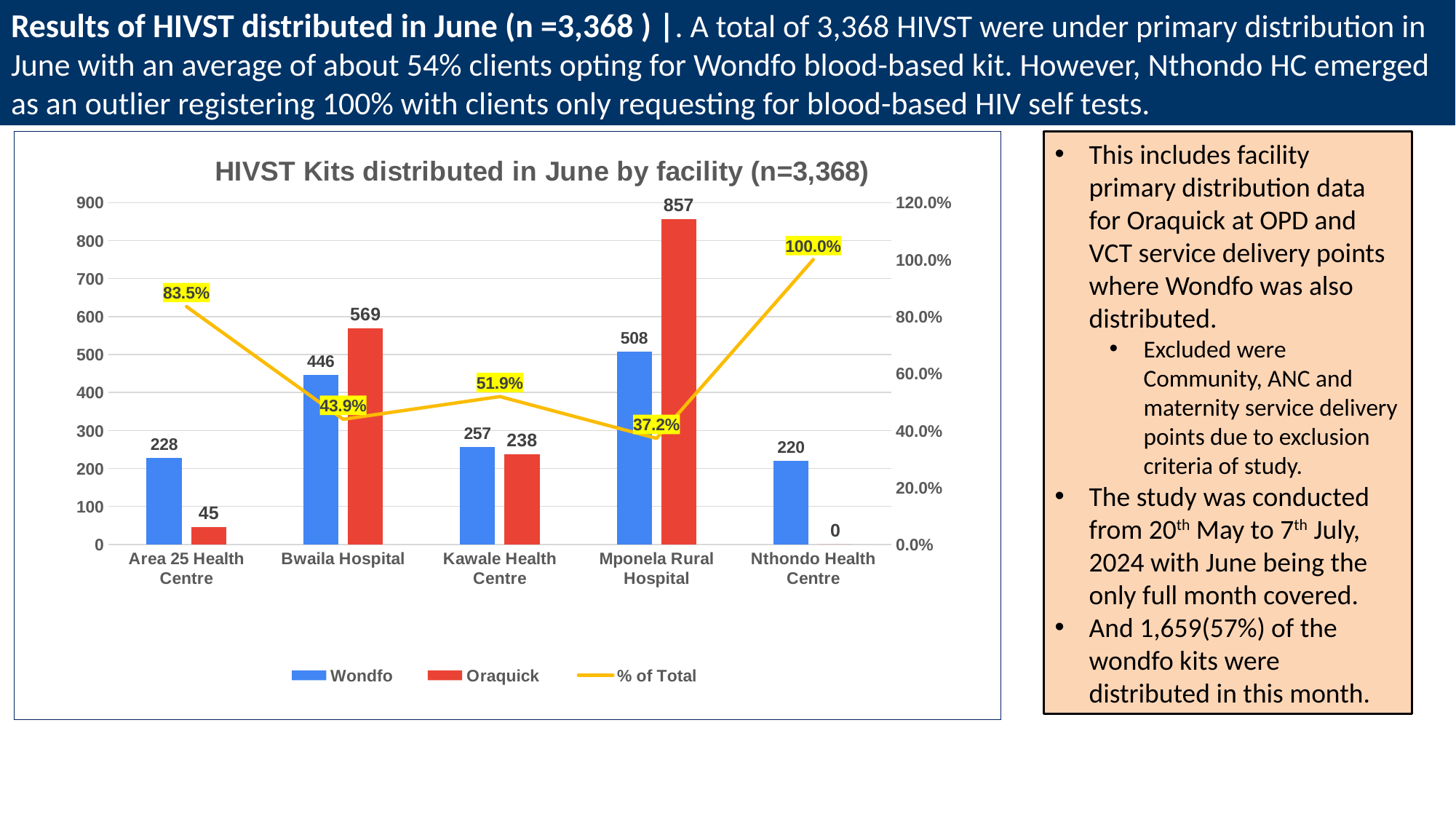
What is the Oraquick value for Area 25 Health Centre? 45 What kind of chart is used to show the Wondfo and Oraquick values? Bar chart What is the difference between the Oraquick and Wondfo values for Bwaila Hospital? 123 What is the title of the chart? HIVST Kits distributed in June by facility (n=3,368) Which facility has the highest Wondfo value? Mponela Rural Hospital How many facilities are shown on the x axis? 5 What is the Wondfo value for Bwaila Hospital? 446 What is the Oraquick value for Mponela Rural Hospital? 857 What is the % of Total value for Nthondo Health Centre? 100.0% Which is larger for Kawale Health Centre, the Wondfo value or the Oraquick value? Wondfo How many series does the legend list? 3 Which facility has the lowest Oraquick value? Nthondo Health Centre